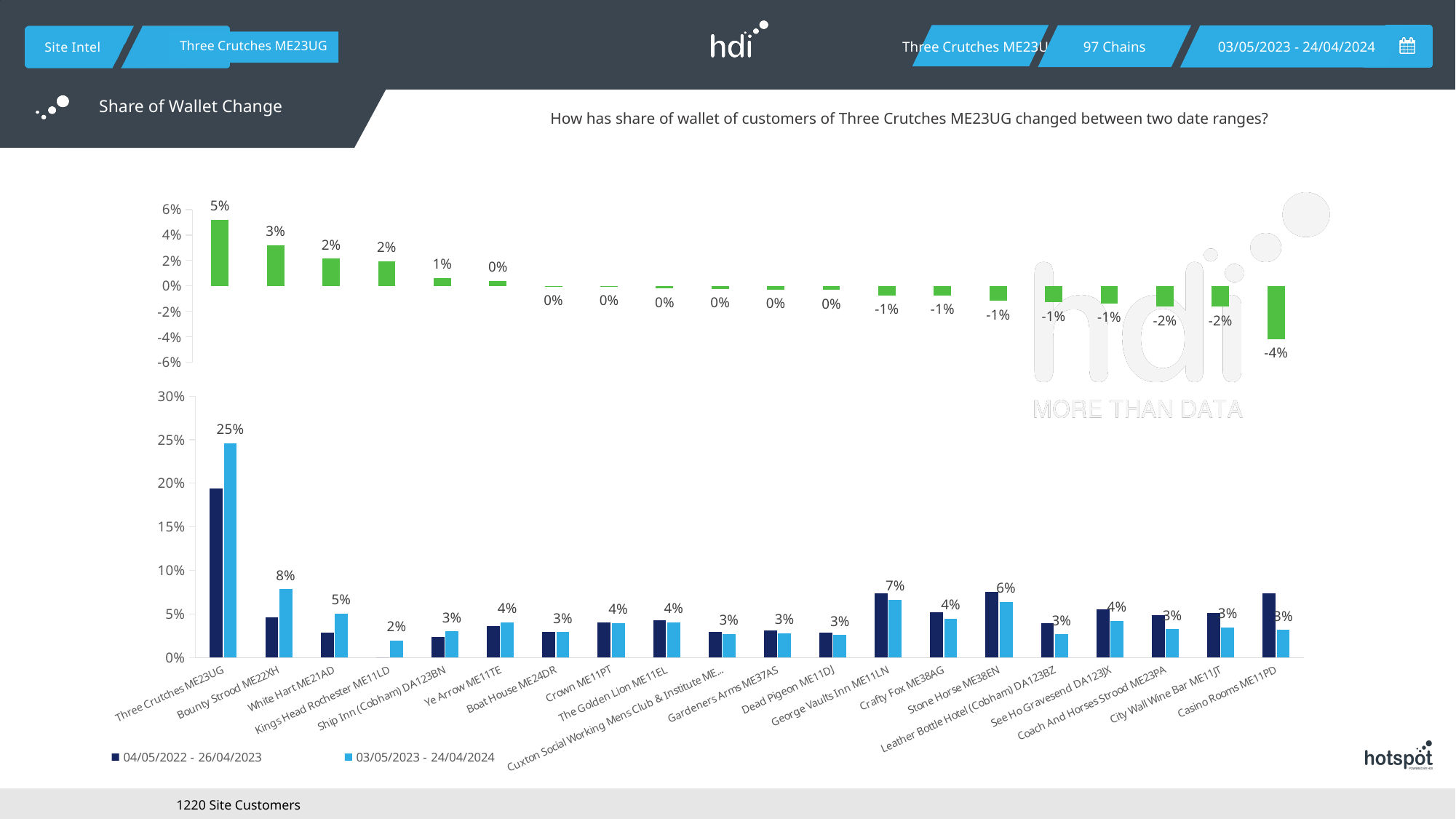
In the bottom chart, which category has the highest value in the 03/05/2023 - 24/04/2024 series? Three Crutches ME23UG In the top chart, what is the highest value shown? 5% In the bottom chart, what is the value for Three Crutches ME23UG in the 03/05/2023 - 24/04/2024 series? 25% In the bottom chart, for Casino Rooms ME11PD, which series has the larger value? 04/05/2022 - 26/04/2023 In the bottom chart, what is the value for Bounty Strood ME22XH in the 03/05/2023 - 24/04/2024 series? 8% In the bottom chart, is the value for Three Crutches ME23UG in the 04/05/2022 - 26/04/2023 series greater or less than 15%? greater How many bars are plotted in the top chart? 20 In the bottom chart, what is the value for White Hart ME21AD in the 03/05/2023 - 24/04/2024 series? 5% In the bottom chart, what is the difference between Three Crutches ME23UG and Bounty Strood ME22XH in the 03/05/2023 - 24/04/2024 series? 17% How many series does the legend of the bottom chart list? 2 In the top chart, what is the lowest value shown? -4% What kind of chart is the top chart on the slide? bar chart